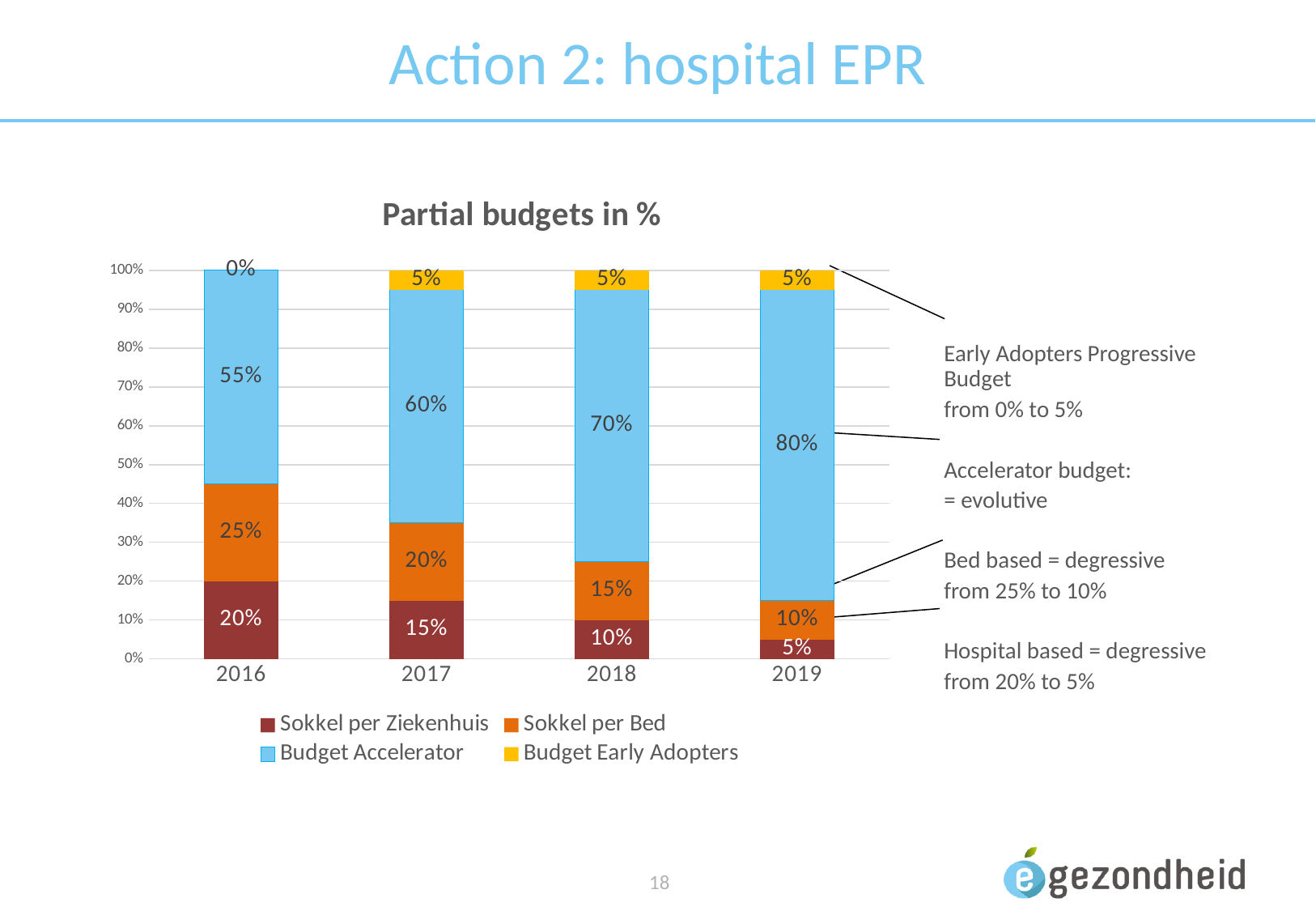
How many series does the legend list? 4 What is the value for Budget Accelerator in 2018? 70% How many years are shown on the x axis? 4 What is the value for Sokkel per Ziekenhuis in 2019? 5% Does Sokkel per Bed rise or fall from 2016 to 2019? Fall In which year is Sokkel per Ziekenhuis lowest? 2019 In which year is Budget Accelerator highest? 2019 What is the value for Sokkel per Bed in 2016? 25% What is the value for Budget Early Adopters in 2016? 0% What kind of chart is shown? Stacked bar chart What is the difference between Budget Accelerator in 2019 and in 2016? 25% Which is larger: Sokkel per Bed in 2017 or Sokkel per Ziekenhuis in 2017? Sokkel per Bed in 2017